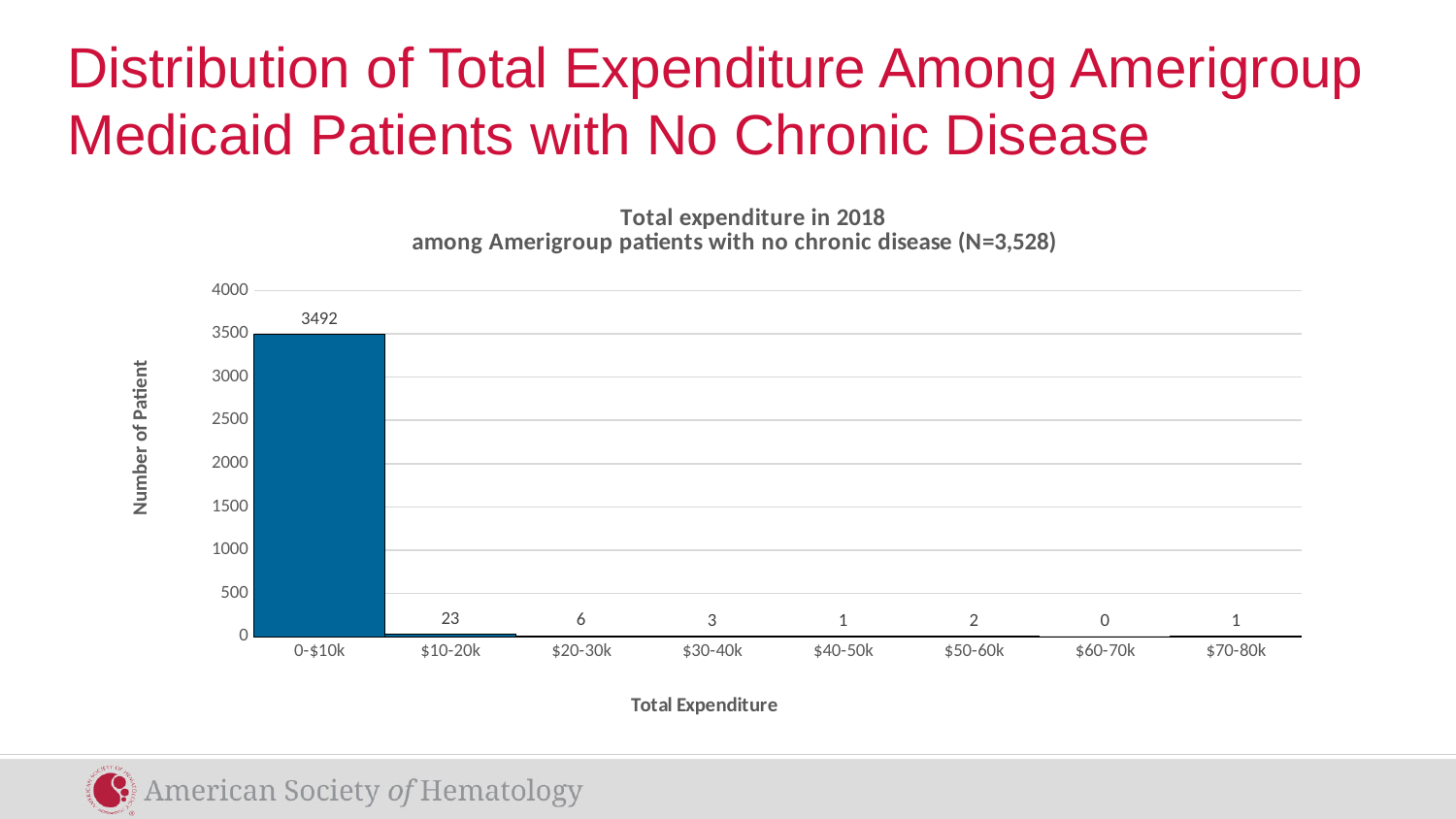
How many patients are in the $10-20k expenditure category? 23 Which expenditure category has the lowest number of patients? $60-70k What is the sample size (N) stated in the chart title? 3,528 What is the difference in number of patients between the 0-$10k and $10-20k categories? 3469 Is the value for 0-$10k greater or less than 3000? greater How many patients are in the $50-60k expenditure category? 2 How many expenditure categories are shown on the x axis? 8 What kind of chart is shown on the slide? bar chart Which expenditure category has the highest number of patients? 0-$10k Which category has more patients, $20-30k or $30-40k? $20-30k What is the label of the y axis? Number of Patient How many patients are in the 0-$10k expenditure category? 3492